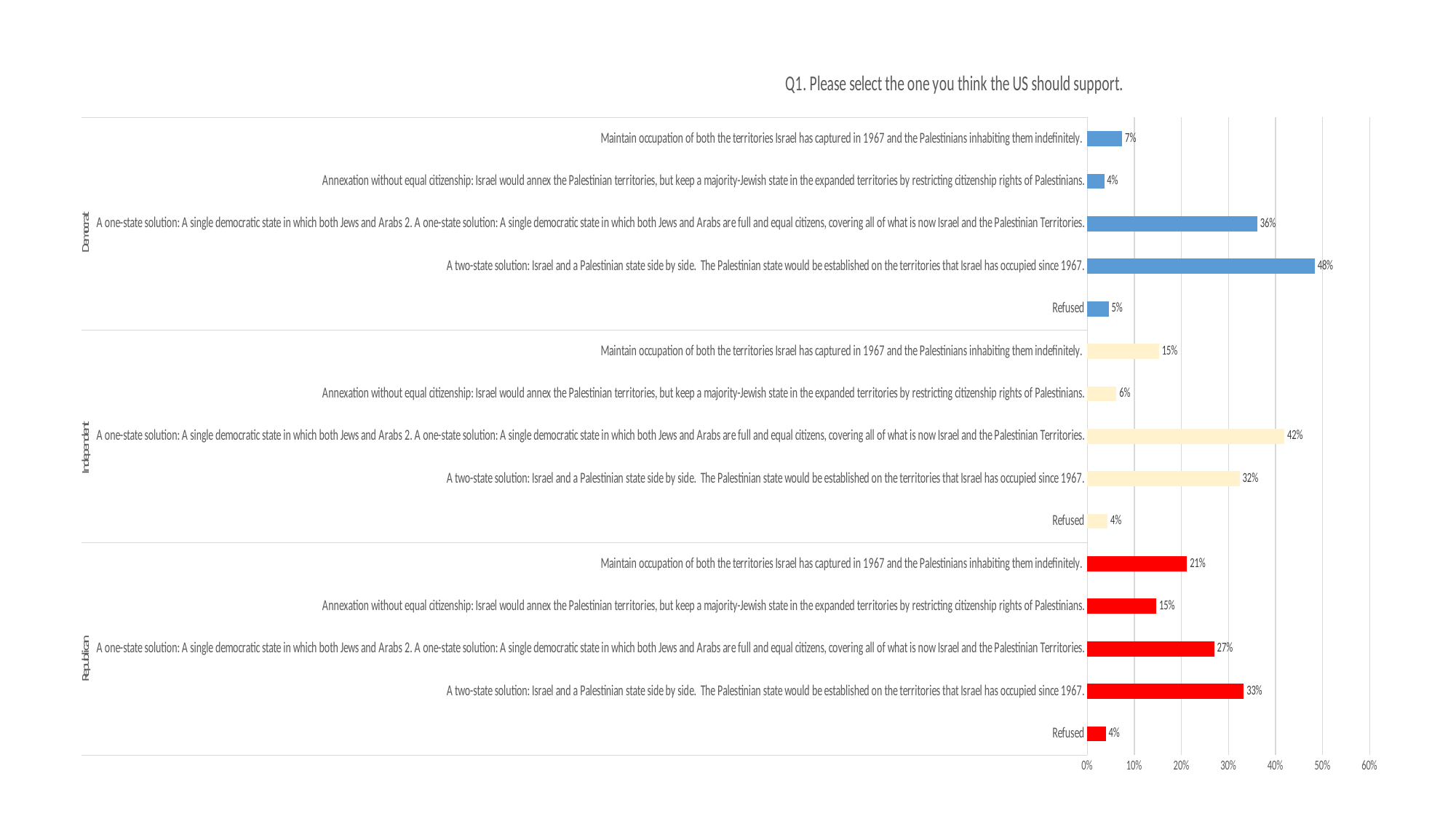
What percentage of Democrats selected the two-state solution? 48% What is the title of the chart? Q1. Please select the one you think the US should support. Which option has the lowest value among Democrats? Annexation without equal citizenship What is the difference between the Democrat and Republican values for the two-state solution? 15% How many party groups are shown on the chart? 3 Is the Democrat value for the one-state solution greater or less than 30%? greater What colour are the bars for the Republican group? red What percentage of Republicans selected maintaining occupation indefinitely? 21% What kind of chart is shown on the slide? bar chart What percentage of Independents selected the one-state solution? 42% Is the Independent value for the two-state solution larger or smaller than the Independent value for the one-state solution? smaller Which option has the highest value among Republicans? A two-state solution